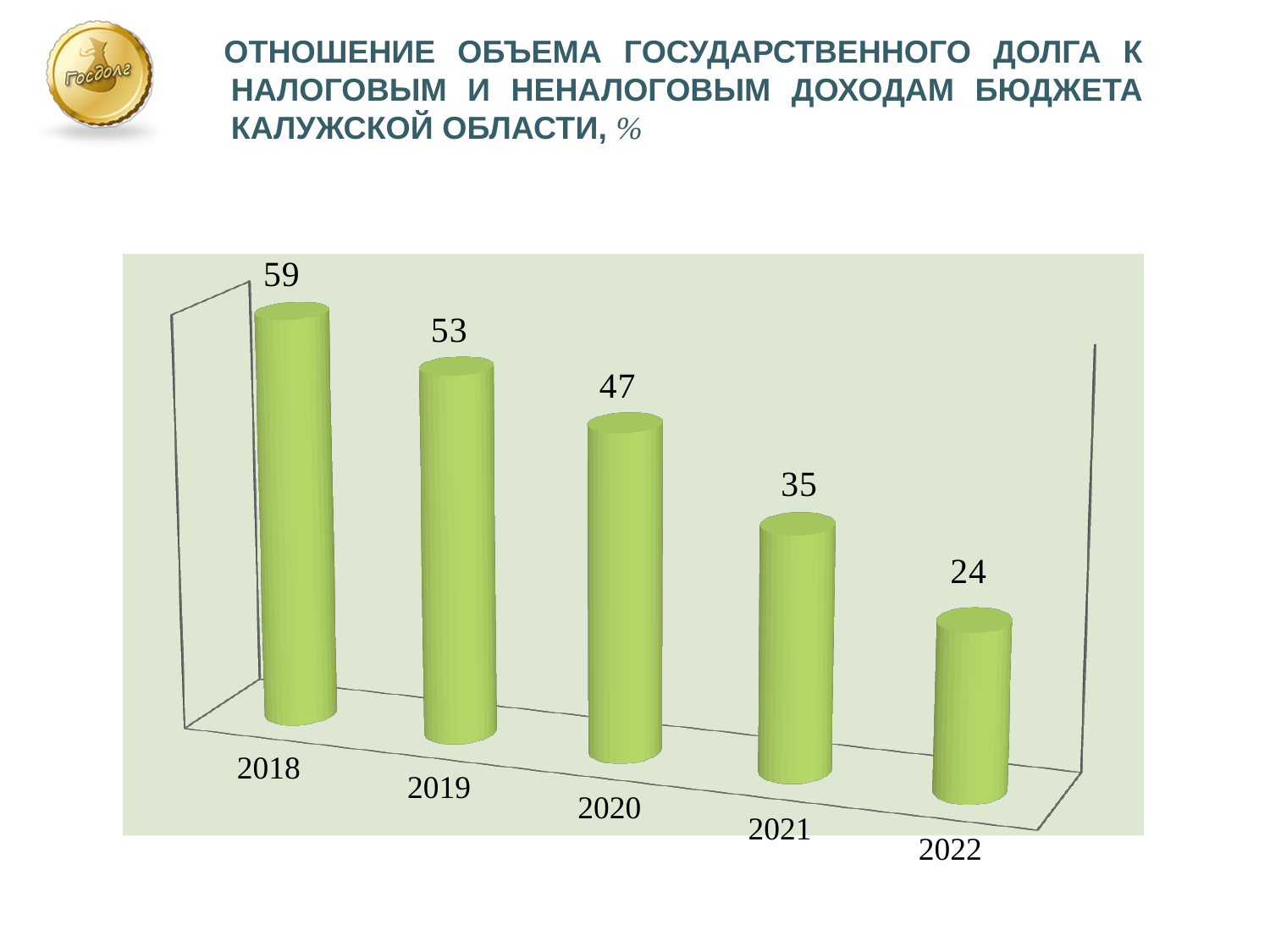
What is the difference between the values for 2018 and 2022? 35 What is the value for 2022? 24 What is the value for 2021? 35 Which year has the highest value? 2018 What is the value for 2020? 47 What is the difference between the values for 2019 and 2020? 6 What is the value for 2018? 59 How many years are shown on the chart? 5 Do the values rise or fall from 2018 to 2022? fall What kind of chart is shown on the slide? bar chart Which is larger, the value for 2019 or the value for 2021? 2019 Which year has the lowest value? 2022